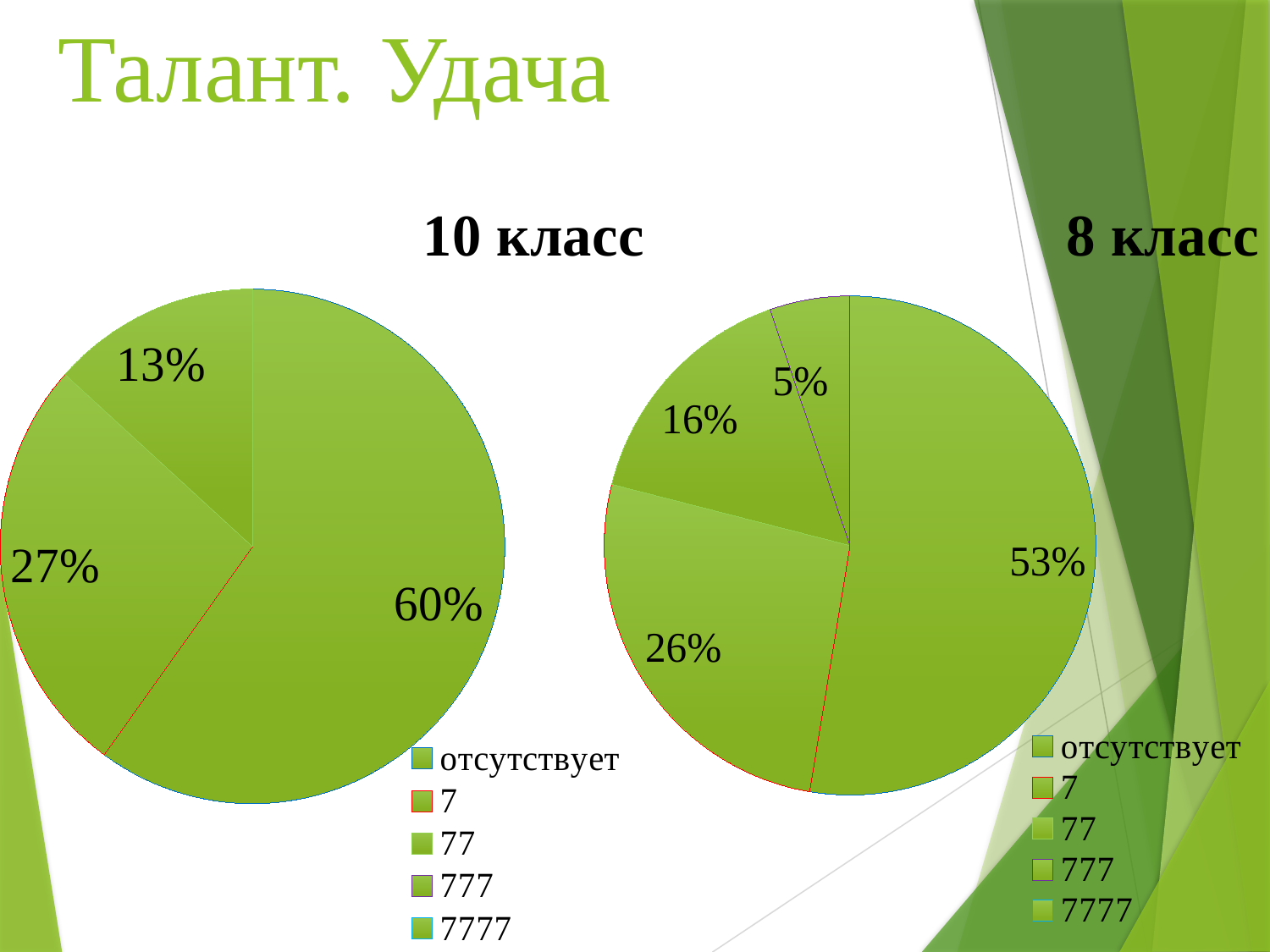
What kind of chart is used for the "10 класс" chart? pie chart How many entries does the legend of the "8 класс" pie chart list? 5 Which is larger: the second-largest slice in the "10 класс" chart (27%) or the second-largest slice in the "8 класс" chart (26%)? 10 класс (27%) In the "8 класс" pie chart, what is the difference in percentage points between the 53% slice and the 26% slice? 27 In the "10 класс" pie chart, what is the percentage of the smallest slice? 13% In the "10 класс" pie chart, what is the percentage of the largest slice? 60% In the "8 класс" pie chart, what is the percentage of the smallest slice? 5% What is the title at the top of the slide containing the two pie charts? Талант. Удача In the "10 класс" pie chart, what is the difference in percentage points between the 60% slice and the 27% slice? 33 In the "8 класс" pie chart, what is the percentage of the largest slice? 53% How many labelled slices does the "10 класс" pie chart have? 3 How many labelled slices does the "8 класс" pie chart have? 4